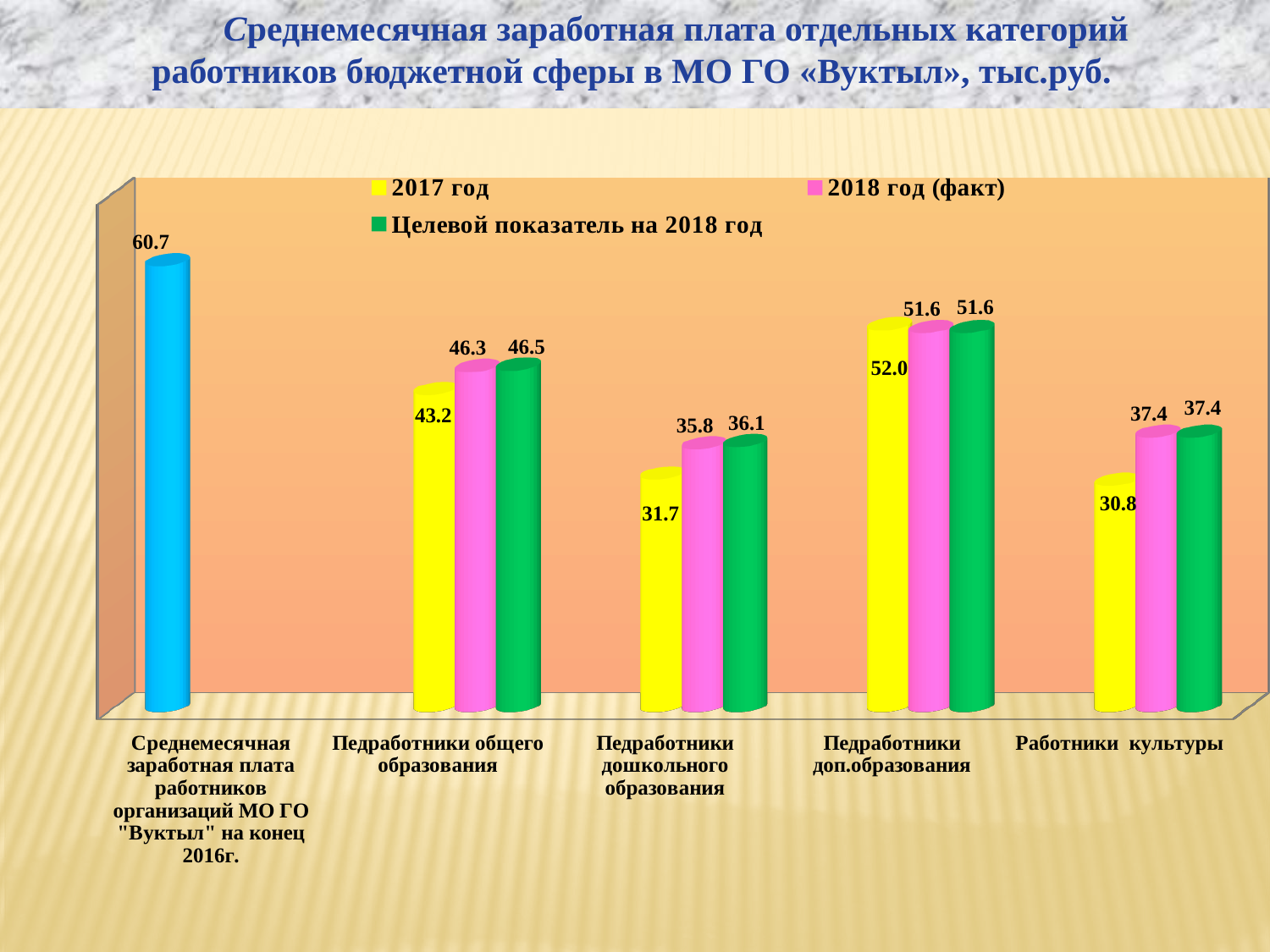
What is the difference between the Целевой показатель на 2018 год and 2017 год values for Педработники дошкольного образования? 4.4 What value is shown for the blue bar labelled Среднемесячная заработная плата работников организаций МО ГО "Вуктыл" на конец 2016г.? 60.7 What is the 2017 год value for Педработники общего образования? 43.2 Which category has the highest 2018 год (факт) value? Педработники доп.образования What is the 2018 год (факт) value for Педработники дошкольного образования? 35.8 How many series does the legend list? 3 What is the Целевой показатель на 2018 год value for Работники культуры? 37.4 What is the 2017 год value for Педработники доп.образования? 52.0 Which category has the lowest 2017 год value? Работники культуры Which is larger for Педработники общего образования: the 2017 год value or the 2018 год (факт) value? 2018 год (факт) What kind of chart is shown on the slide? Bar chart What is the difference between the 2018 год (факт) and 2017 год values for Работники культуры? 6.6